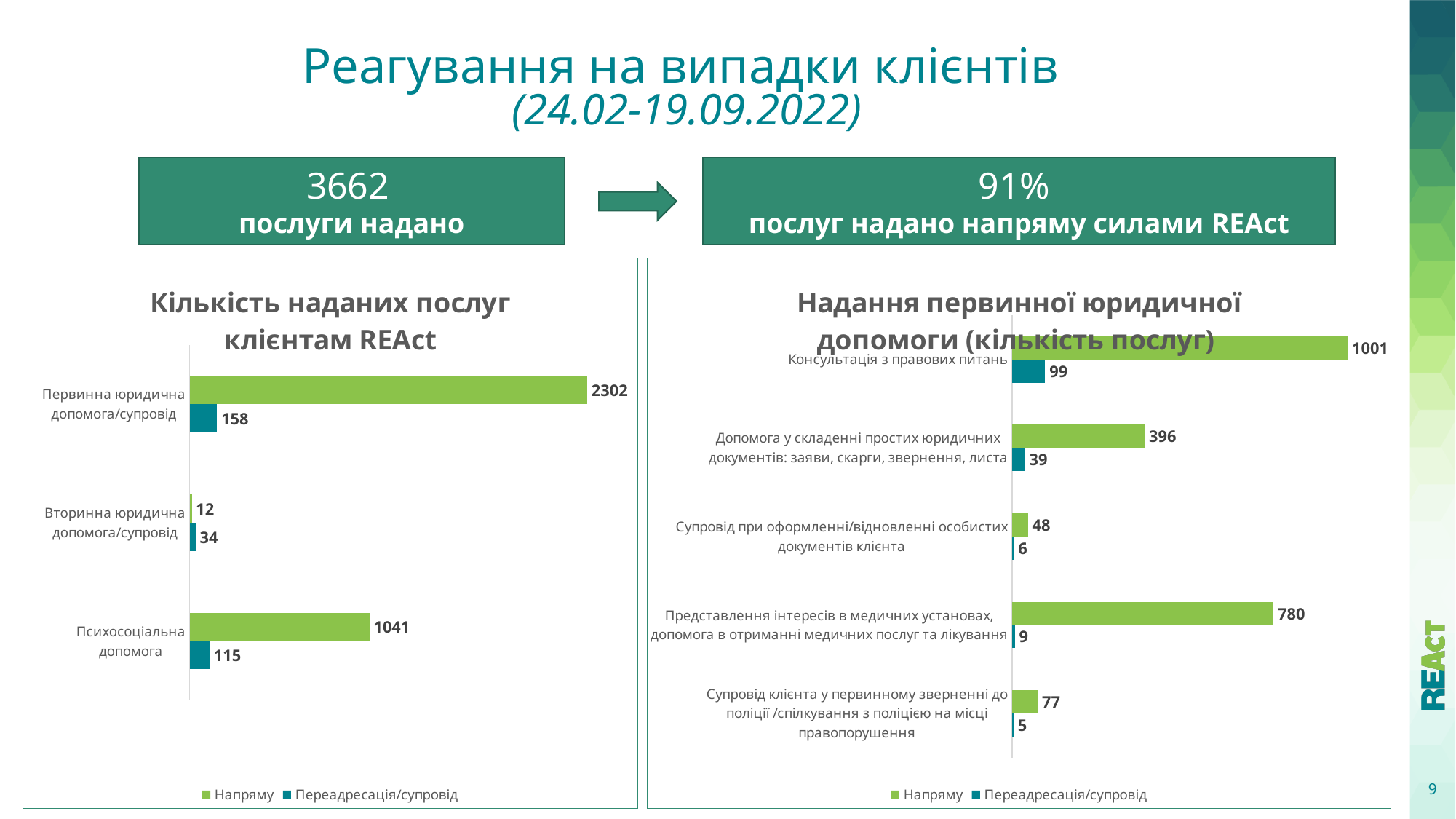
In the chart 'Надання первинної юридичної допомоги (кількість послуг)', how many categories are shown? 5 In the chart 'Надання первинної юридичної допомоги (кількість послуг)', which category has the highest 'Напряму' value? Консультація з правових питань In the chart 'Надання первинної юридичної допомоги (кількість послуг)', which is larger: the 'Напряму' value for 'Представлення інтересів в медичних установах, допомога в отриманні медичних послуг та лікування' or for 'Допомога у складенні простих юридичних документів: заяви, скарги, звернення, листа'? Представлення інтересів в медичних установах, допомога в отриманні медичних послуг та лікування In the chart 'Кількість наданих послуг клієнтам REAct', which category has the lowest 'Напряму' value? Вторинна юридична допомога/супровід In the chart 'Кількість наданих послуг клієнтам REAct', what is the difference between the 'Напряму' and 'Переадресація/супровід' values for 'Психосоціальна допомога'? 926 In the chart 'Кількість наданих послуг клієнтам REAct', what is the 'Напряму' value for 'Первинна юридична допомога/супровід'? 2302 In the chart 'Кількість наданих послуг клієнтам REAct', what is the 'Переадресація/супровід' value for 'Психосоціальна допомога'? 115 In the chart 'Надання первинної юридичної допомоги (кількість послуг)', what is the 'Напряму' value for 'Консультація з правових питань'? 1001 In the chart 'Надання первинної юридичної допомоги (кількість послуг)', what is the difference between the 'Напряму' and 'Переадресація/супровід' values for 'Консультація з правових питань'? 902 In the chart 'Кількість наданих послуг клієнтам REAct', how many series does the legend list? 2 In the chart 'Надання первинної юридичної допомоги (кількість послуг)', what is the 'Переадресація/супровід' value for 'Допомога у складенні простих юридичних документів: заяви, скарги, звернення, листа'? 39 What type of chart is 'Кількість наданих послуг клієнтам REAct'? Bar chart